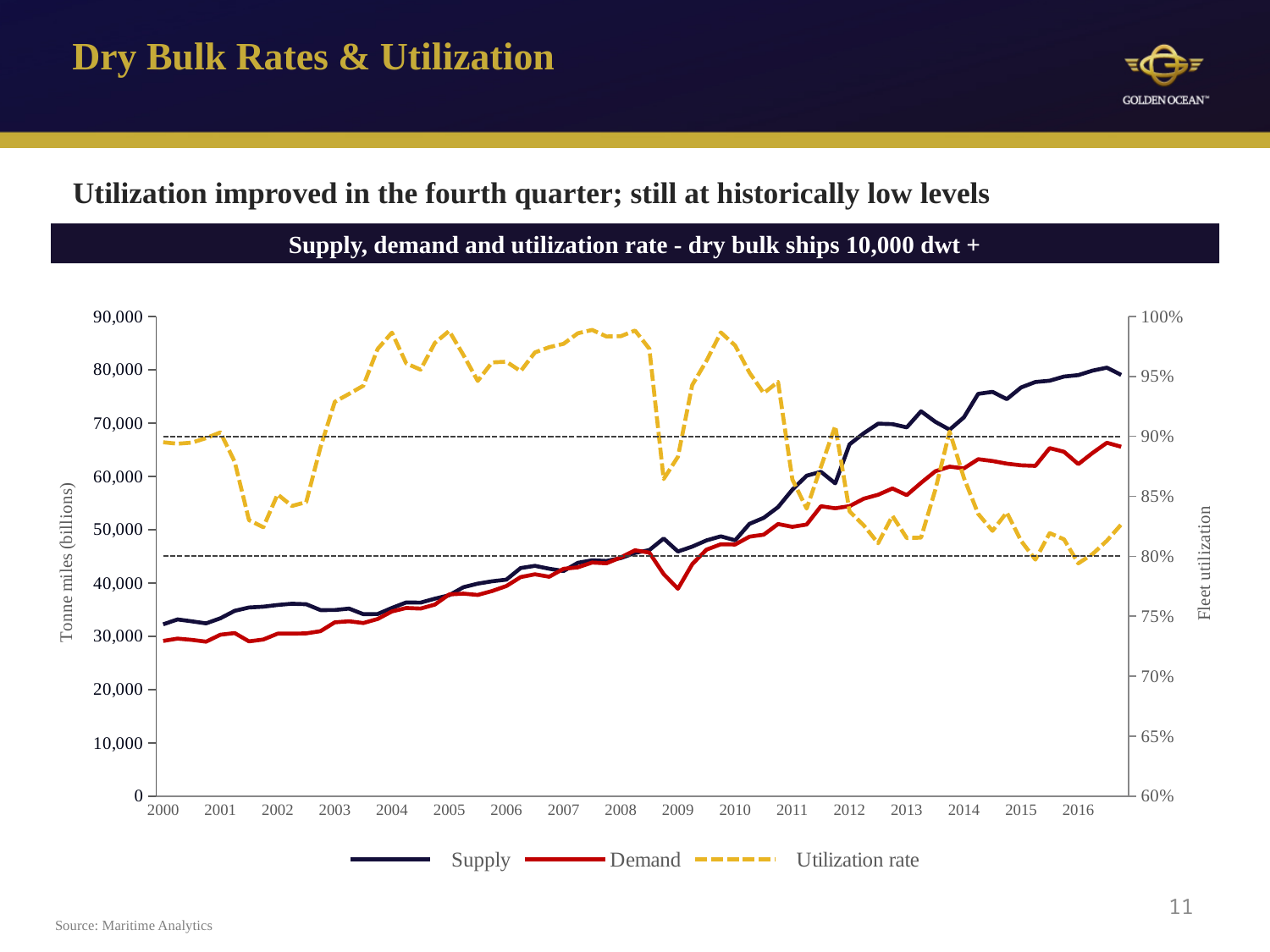
Is the Demand value in 2000 greater or less than 40,000? less Is the Supply value in 2008 greater or less than 50,000? less Does the Supply line generally rise or fall from 2000 to 2016? Rise How many years are labelled on the x axis? 17 How many series does the legend list? 3 In 2016, which is larger, Supply or Demand? Supply What kind of chart is shown on the slide? Line chart Is the Supply value in 2016 greater or less than 70,000? greater What are the three series named in the legend? Supply, Demand, Utilization rate What is the title of the chart? Supply, demand and utilization rate - dry bulk ships 10,000 dwt +